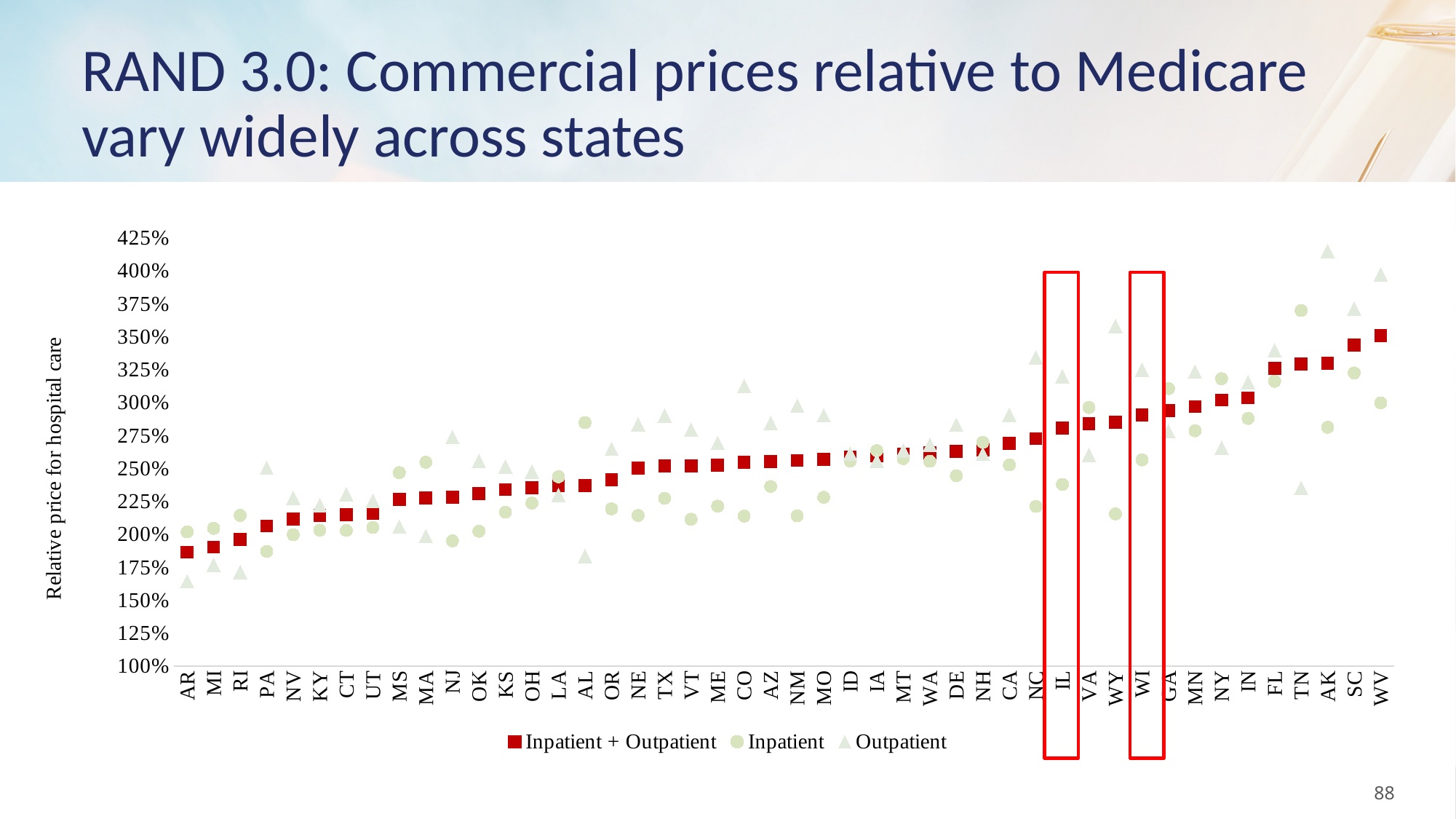
Is the Inpatient + Outpatient value for WV greater or less than 325%? greater Which state has the lowest Inpatient + Outpatient value? AR Is the Inpatient + Outpatient value for AR greater or less than 200%? less Do the Inpatient + Outpatient values rise or fall moving from left to right along the x axis? Rise Which state has the larger Inpatient + Outpatient value, NC or FL? FL Which state has the highest Inpatient + Outpatient value? WV Which state has the highest Outpatient value? AK Is the Outpatient value for AK greater or less than 400%? greater Which two states are highlighted with red boxes on the chart? IL and WI Which state has the highest Inpatient value? TN How many series does the legend list? 3 What kind of chart is shown on the slide? Scatter (dot) chart